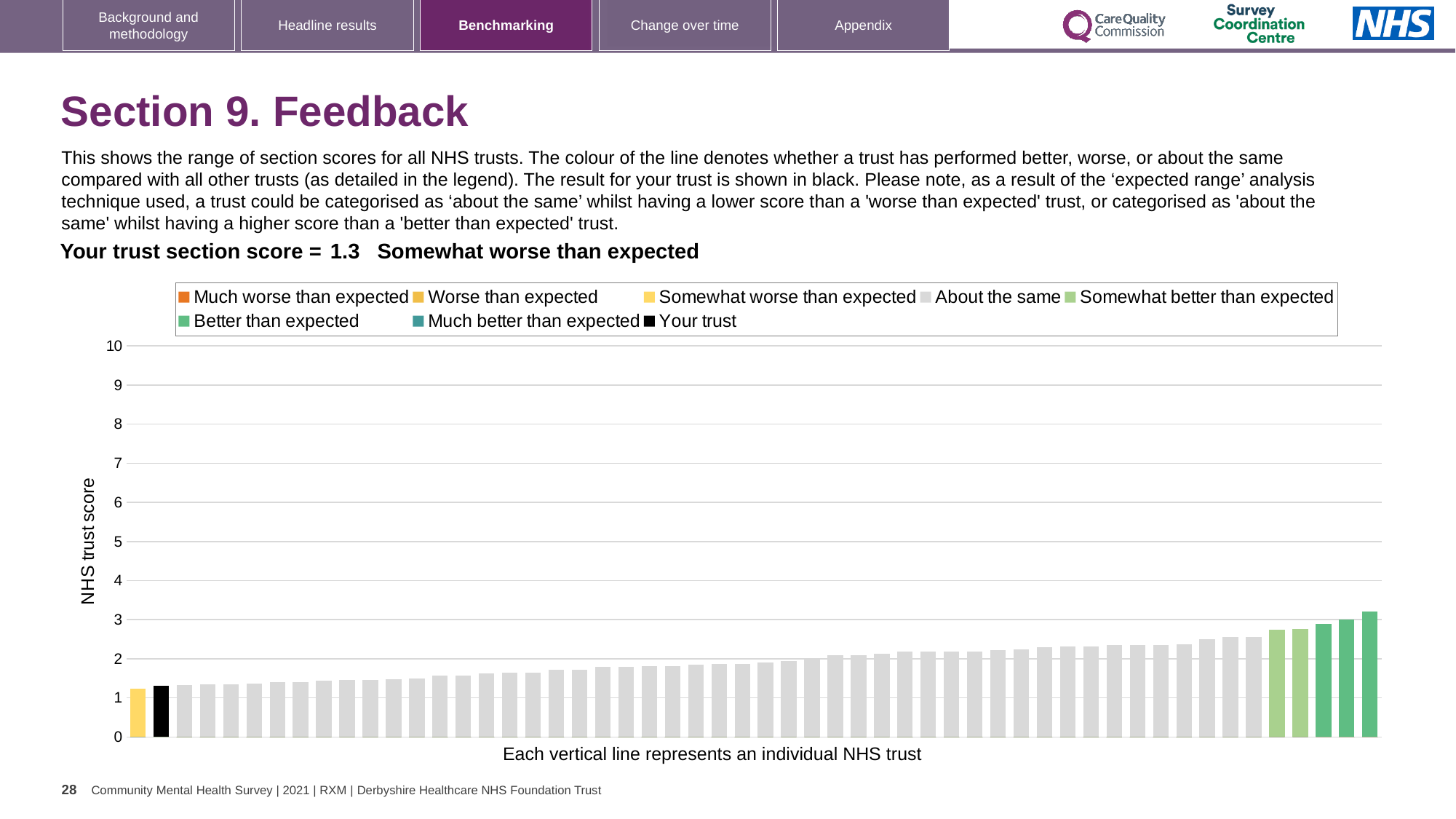
Is the lowest bar in the chart greater or less than 2? less Is the score for your trust (the black bar) greater or less than 2? less Which performance category does the tallest bar in the chart belong to? Better than expected Is the tallest bar in the chart greater or less than 4? less Do the bar values rise or fall from left to right across the chart? rise Which performance category is your trust placed in for Section 9. Feedback? Somewhat worse than expected What kind of chart is shown on the slide? Bar chart How many entries does the chart legend list? 8 What is the label on the vertical axis of the chart? NHS trust score What is the maximum value shown on the vertical axis? 10 Which is larger: the score for your trust (black bar) or the score of the rightmost bar? The rightmost bar What is the section score for your trust shown on the slide? 1.3